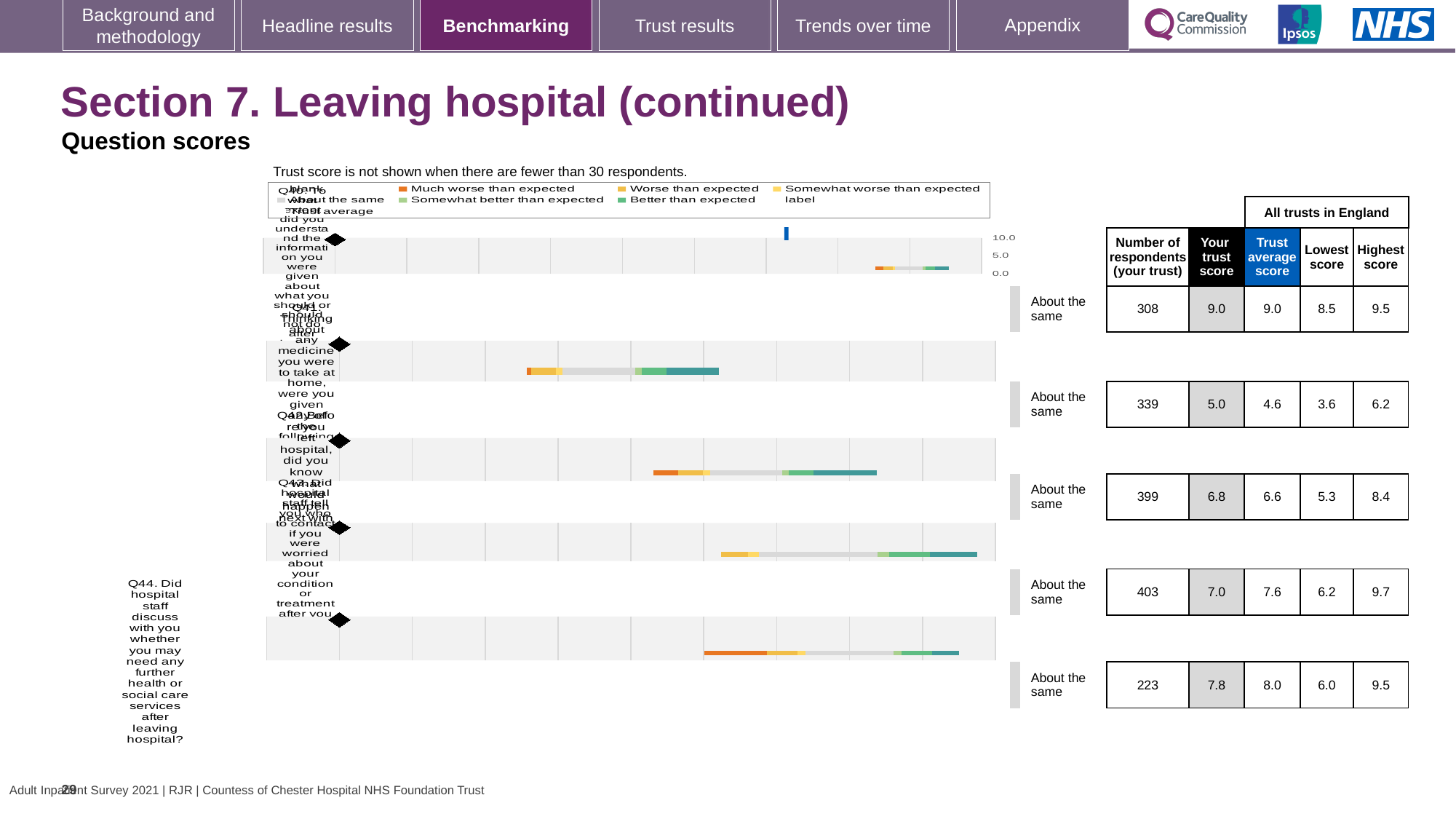
In the table beside the chart, which row has the lowest 'Your trust score'? the second row (5.0) Which legend entry is shown in orange? Much worse than expected In the table beside the chart, is 'Your trust score' in the fourth row (7.0) larger or smaller than the Trust average score (7.6)? smaller In the table beside the chart, what is the Trust average score for the first row? 9.0 In the table beside the chart, what is 'Your trust score' for the last row (Q44)? 7.8 What is the highest value shown on the chart's numeric axis? 10.0 What kind of chart is shown on the slide? bar chart In the table beside the chart, what is the difference between the Highest score and Lowest score in the second row? 2.6 How many question rows (bars) does the chart show? 5 In the table beside the chart, what is the number of respondents for the last row (Q44)? 223 How many rows of the chart are labelled 'About the same' in the column to the right of the bars? 5 In the table beside the chart, which row has the highest number of respondents? the fourth row (403)